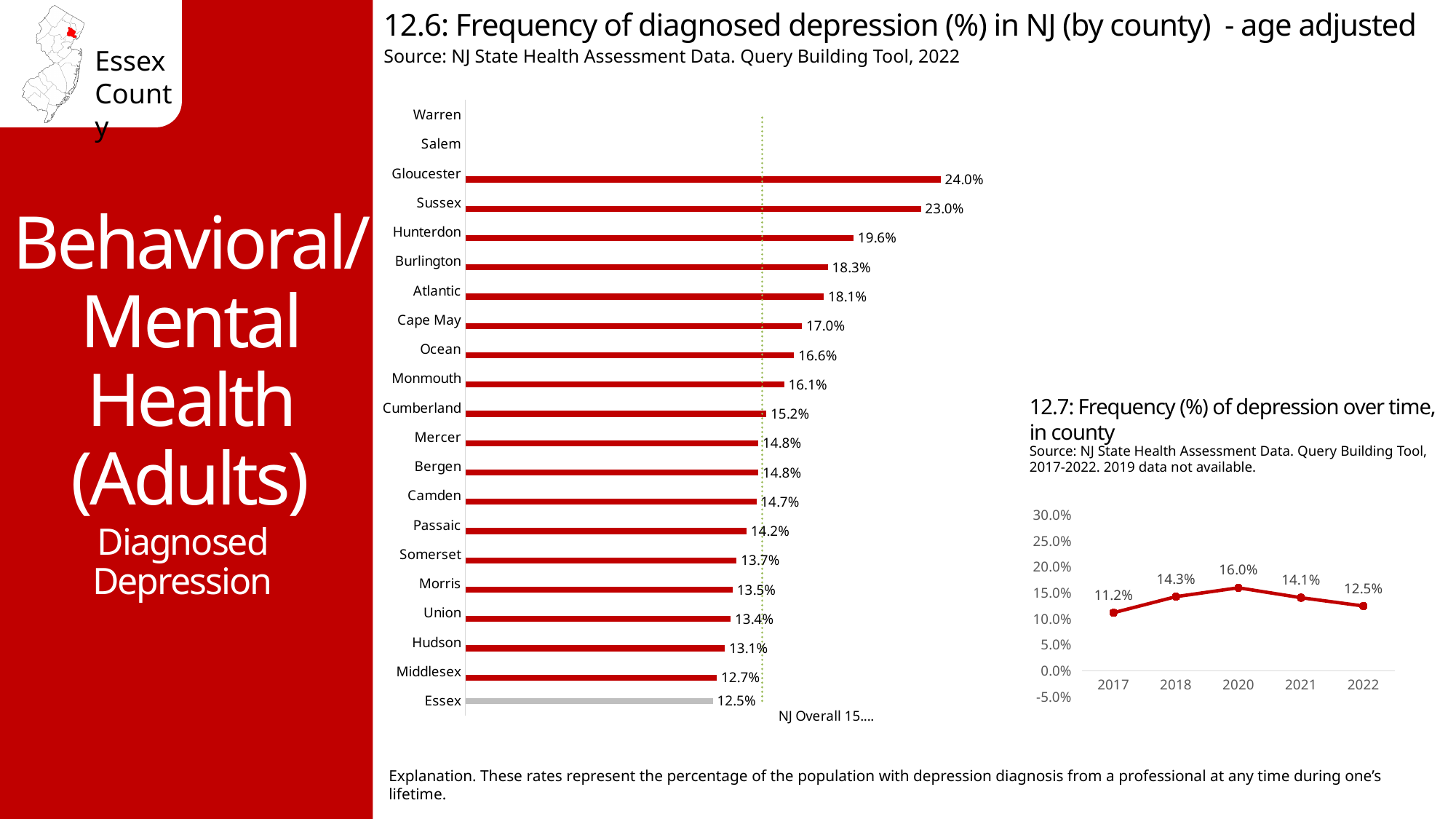
In the chart 12.7 (frequency of depression over time in county), which year has the lowest value? 2017 In the chart 12.6 (frequency of diagnosed depression by county), how many counties have a bar plotted? 19 In the chart 12.7 (frequency of depression over time in county), do the values rise or fall from 2020 to 2022? Fall What type of chart is chart 12.6 (frequency of diagnosed depression by county)? Bar chart In the chart 12.6 (frequency of diagnosed depression by county), which is larger, Burlington or Cape May? Burlington In the chart 12.6 (frequency of diagnosed depression by county), what is the difference between Sussex and Hunterdon? 3.4% In the chart 12.6 (frequency of diagnosed depression by county), which county with a plotted bar has the lowest value? Essex In the chart 12.6 (frequency of diagnosed depression by county), what is the value for Essex? 12.5% In the chart 12.6 (frequency of diagnosed depression by county), what is the value for Gloucester? 24.0% In the chart 12.7 (frequency of depression over time in county), how many data points are plotted? 5 In the chart 12.6 (frequency of diagnosed depression by county), which county with a plotted bar has the highest value? Gloucester In the chart 12.7 (frequency of depression over time in county), what is the value for 2020? 16.0%